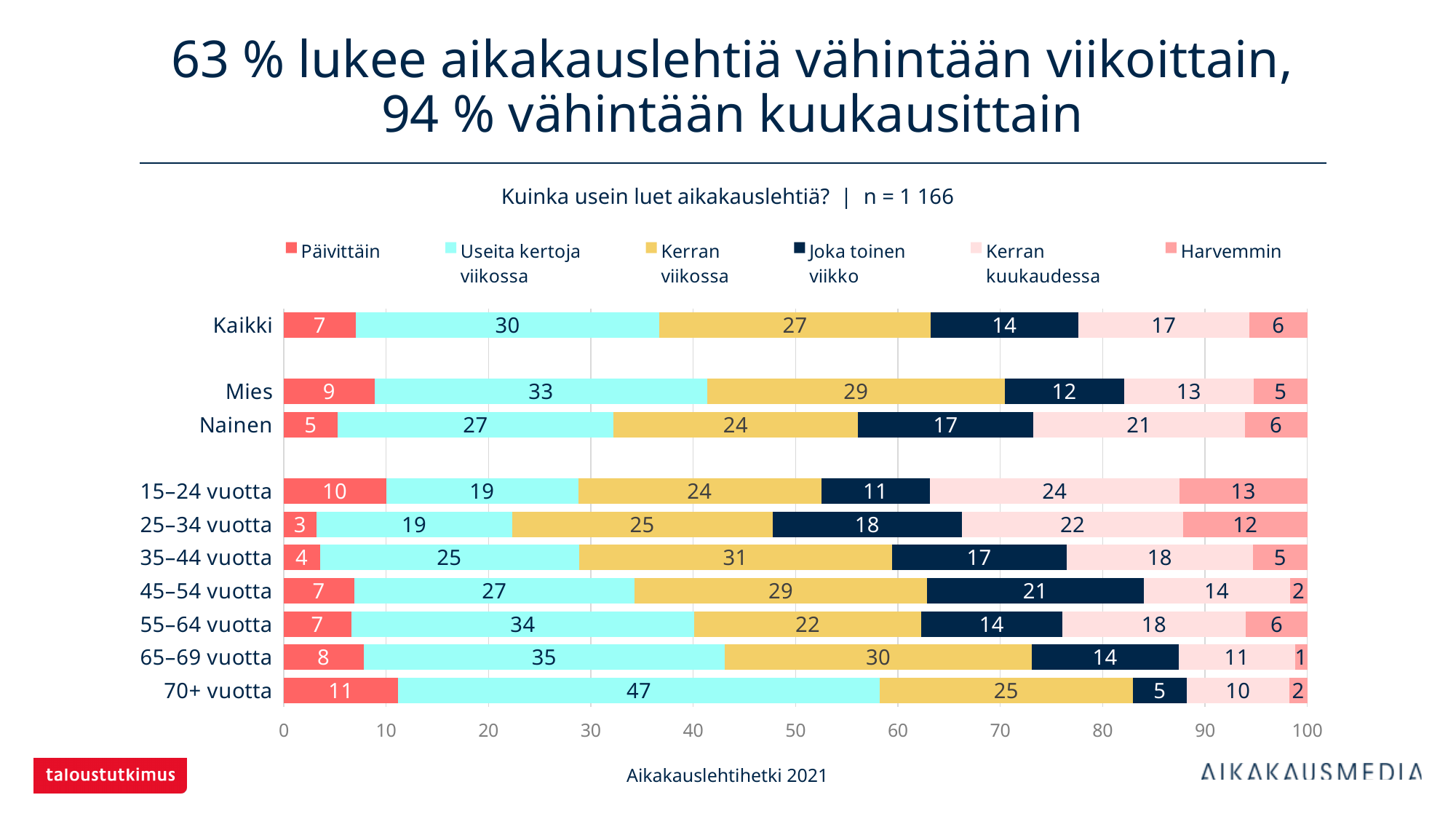
What sample size (n) is stated above the chart? n = 1 166 What kind of chart is shown on the slide? Stacked bar chart What is the value for "Useita kertoja viikossa" in the 70+ vuotta bar? 47 Which has the larger "Päivittäin" value, Mies or Nainen? Mies How much larger is the "Kerran kuukaudessa" value for Nainen than for Mies? 8 Which category has the highest "Useita kertoja viikossa" value? 70+ vuotta Which category has the lowest "Päivittäin" value? 25–34 vuotta How many series does the legend list? 6 What is the "Joka toinen viikko" value for 45–54 vuotta? 21 How many categories (bars) are shown in the chart? 10 What is the "Päivittäin" value for Kaikki? 7 What is the total of the stacked bar for Nainen? 100